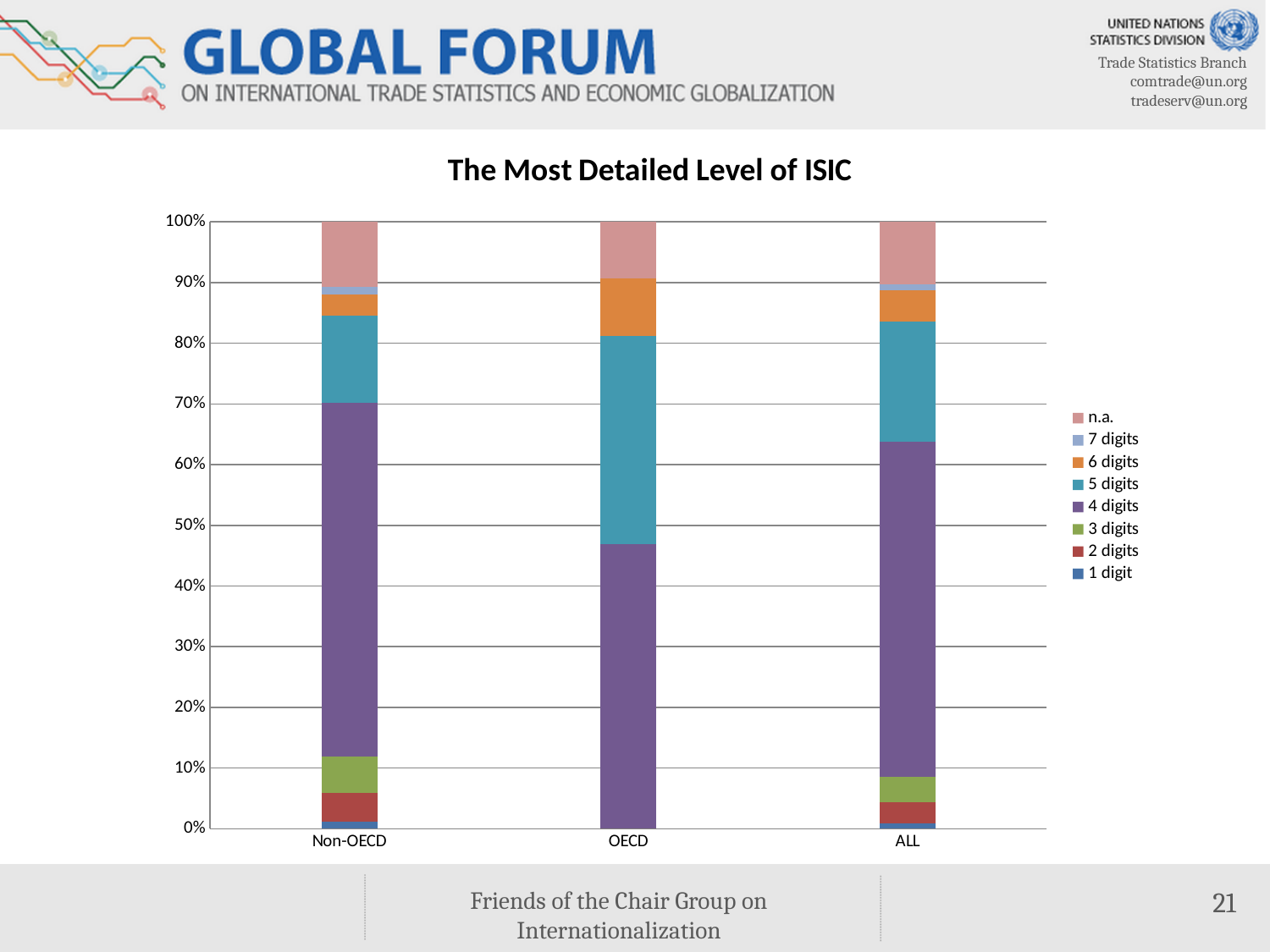
Is the 4 digits share for Non-OECD greater or less than 50%? greater Which category has the largest 5 digits segment? OECD Is the 4 digits share for OECD greater or less than 40%? greater Is the 6 digits segment larger for OECD or for Non-OECD? OECD What is the title of the chart? The Most Detailed Level of ISIC What is the total height of the OECD stacked bar? 100% Which category shows no visible 1 digit, 2 digits or 3 digits segments? OECD How many series does the legend list? 8 How many categories are shown on the x axis of the chart? 3 What type of chart is shown on the slide? Stacked bar chart Is the 3 digits share for Non-OECD greater or less than 10%? less Is the 5 digits segment larger for OECD or for Non-OECD? OECD